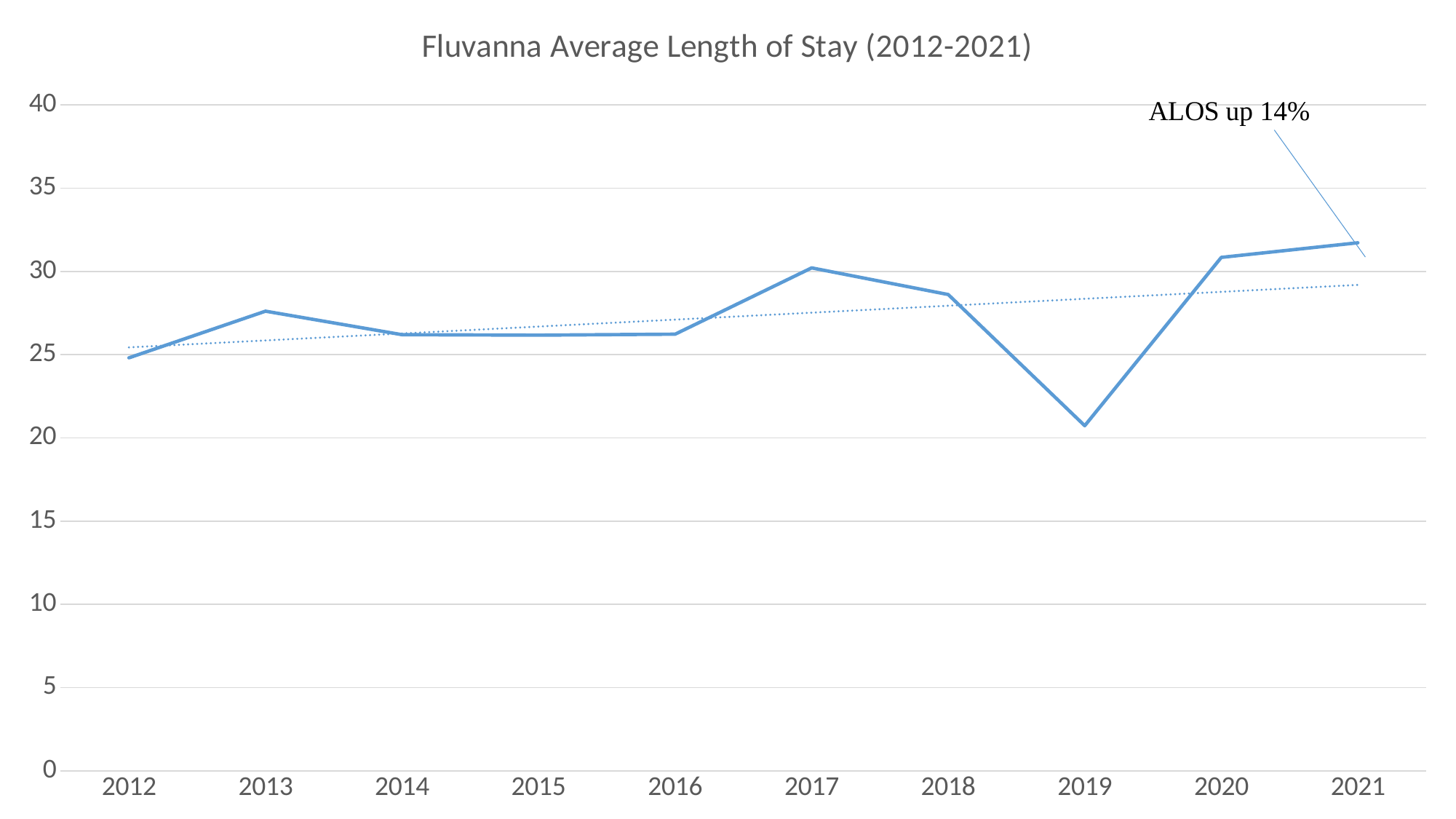
What is the title of the chart? Fluvanna Average Length of Stay (2012-2021) Is the value for 2021 greater or less than 30? greater What type of chart is shown on the slide? line chart Which year has the lowest average length of stay? 2019 Does the dotted trend line rise or fall from 2012 to 2021? rises Is the value for 2019 greater or less than 25? less What does the annotation pointing to the 2021 data point say? ALOS up 14% Is the value for 2018 greater or less than 30? less How many years are plotted on the x axis? 10 Which year has the highest average length of stay? 2021 Which year has the larger value, 2017 or 2019? 2017